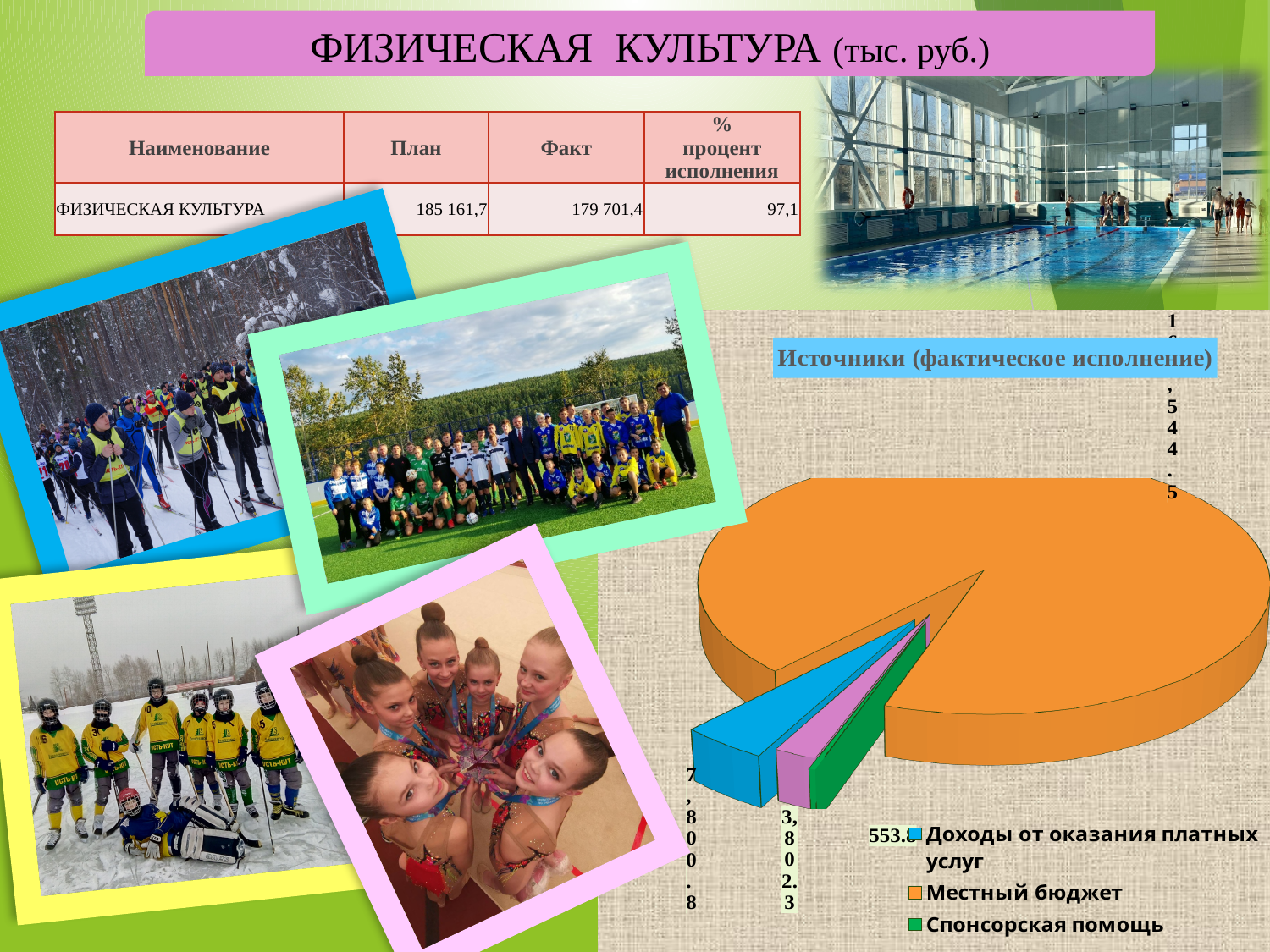
Which is larger in the pie chart: Местный бюджет or Доходы от оказания платных услуг? Местный бюджет What kind of chart is shown on the right side of the slide? pie chart Which colour represents Спонсорская помощь in the pie chart? green What is the title of the pie chart? Источники (фактическое исполнение) Which source has the largest slice in the pie chart? Местный бюджет How many entries does the legend of the pie chart list? 3 What value is labelled on the blue slice (Доходы от оказания платных услуг) of the pie chart? 7,800.8